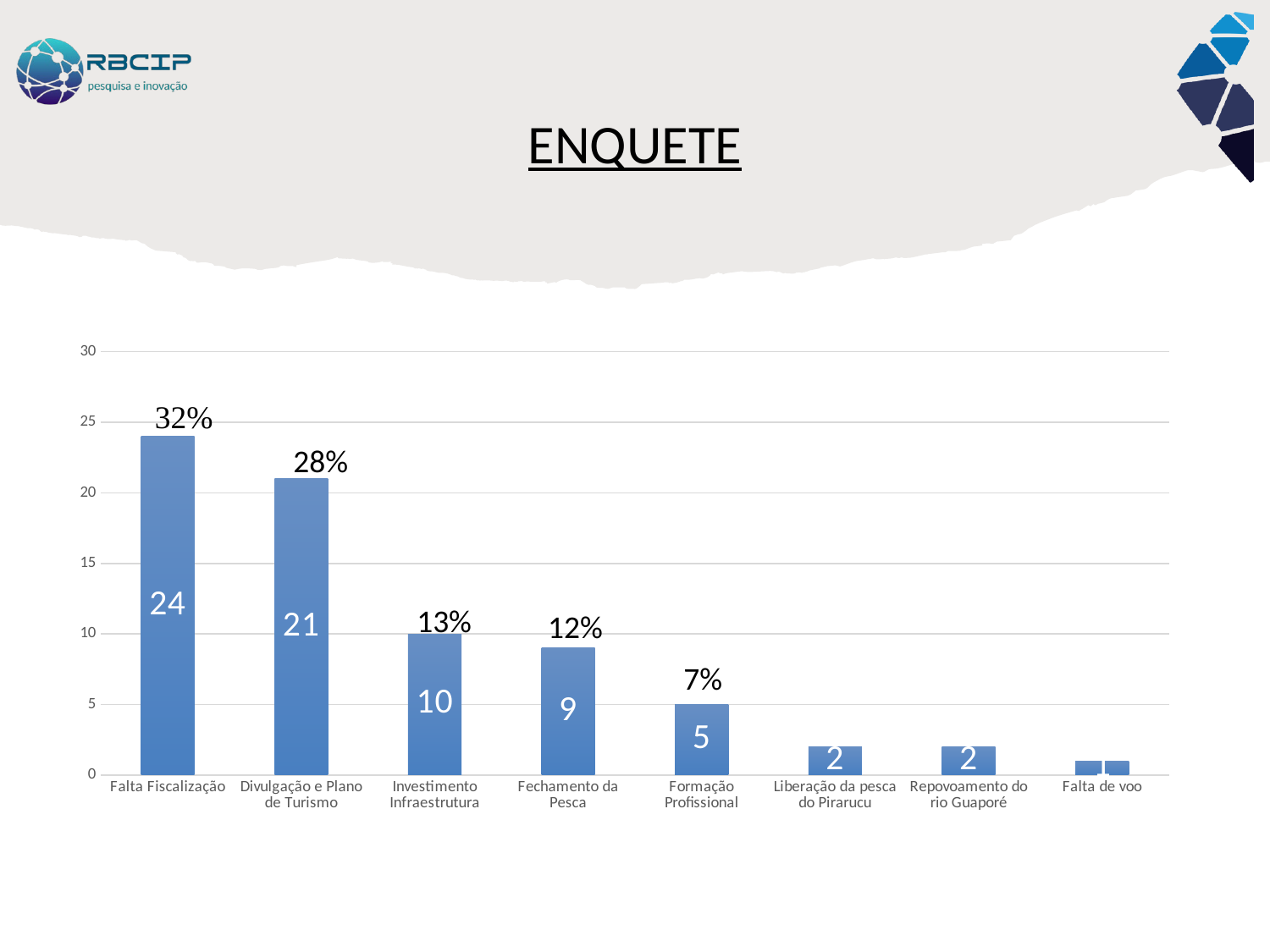
What percentage is shown above the bar for Investimento Infraestrutura? 13% What is the value for Formação Profissional? 5 What is the value for Liberação da pesca do Pirarucu? 2 What is the difference between the values for Falta Fiscalização and Divulgação e Plano de Turismo? 3 Is the value for Fechamento da Pesca greater or less than 10? less What is the title of the slide? ENQUETE What is the value for Divulgação e Plano de Turismo? 21 What kind of chart is shown on the slide? bar chart What is the value for Falta Fiscalização? 24 How many categories are shown on the x axis? 8 Which category has the highest value? Falta Fiscalização Which is larger, the value for Investimento Infraestrutura or Fechamento da Pesca? Investimento Infraestrutura